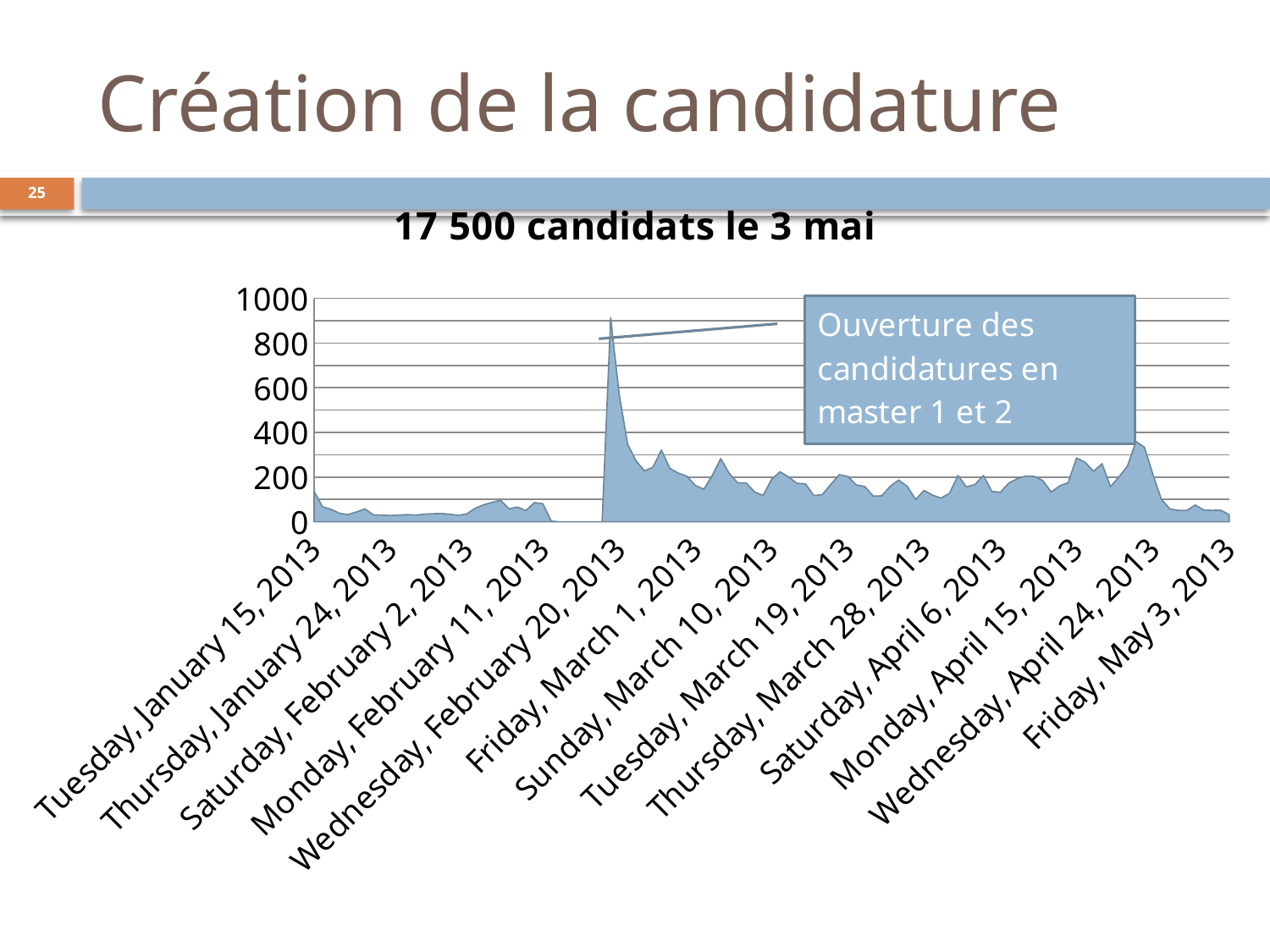
Is the peak value of the chart greater or less than 800? greater Is the value for Tuesday, January 15, 2013 greater or less than 200? less What does the text box overlaid on the chart say? Ouverture des candidatures en master 1 et 2 Between Tuesday, January 15, 2013 and Monday, February 11, 2013, do the values stay below 200 or go above 200? stay below 200 What kind of chart is shown on the slide? area chart Do the values rise or fall immediately after the large spike in late February? fall How many date labels are shown on the horizontal axis? 13 What is the highest value shown on the vertical axis? 1000 What is the title shown above the chart? 17 500 candidats le 3 mai Which is larger, the value for Friday, March 1, 2013 or the value for Friday, May 3, 2013? Friday, March 1, 2013